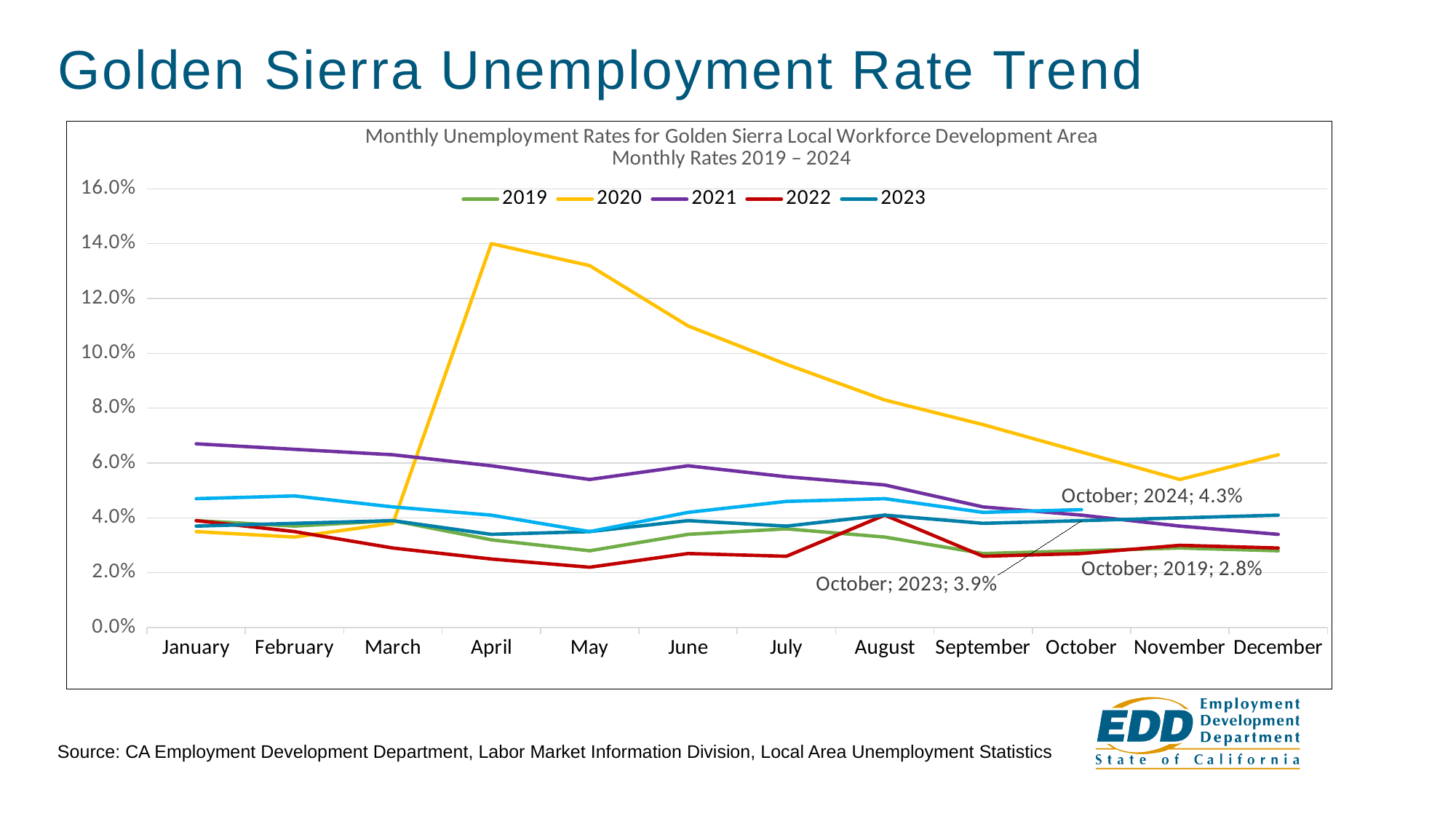
Is the 2020 value for April greater or less than 12.0%? greater What is the labelled unemployment rate for October 2024? 4.3% What is the labelled unemployment rate for October 2023? 3.9% What kind of chart is shown on the slide? Line chart Which is larger, the labelled October 2024 rate or the labelled October 2019 rate? October 2024 How many series does the chart's legend list? 5 How many months are shown along the x axis of the chart? 12 Which year's line reaches the highest value on the chart? 2020 What is the labelled unemployment rate for October 2019? 2.8% Does the 2020 line rise or fall from April to November? Fall In which month does the 2020 line reach its peak? April What is the difference between the labelled October 2024 rate and the labelled October 2023 rate? 0.4 percentage points